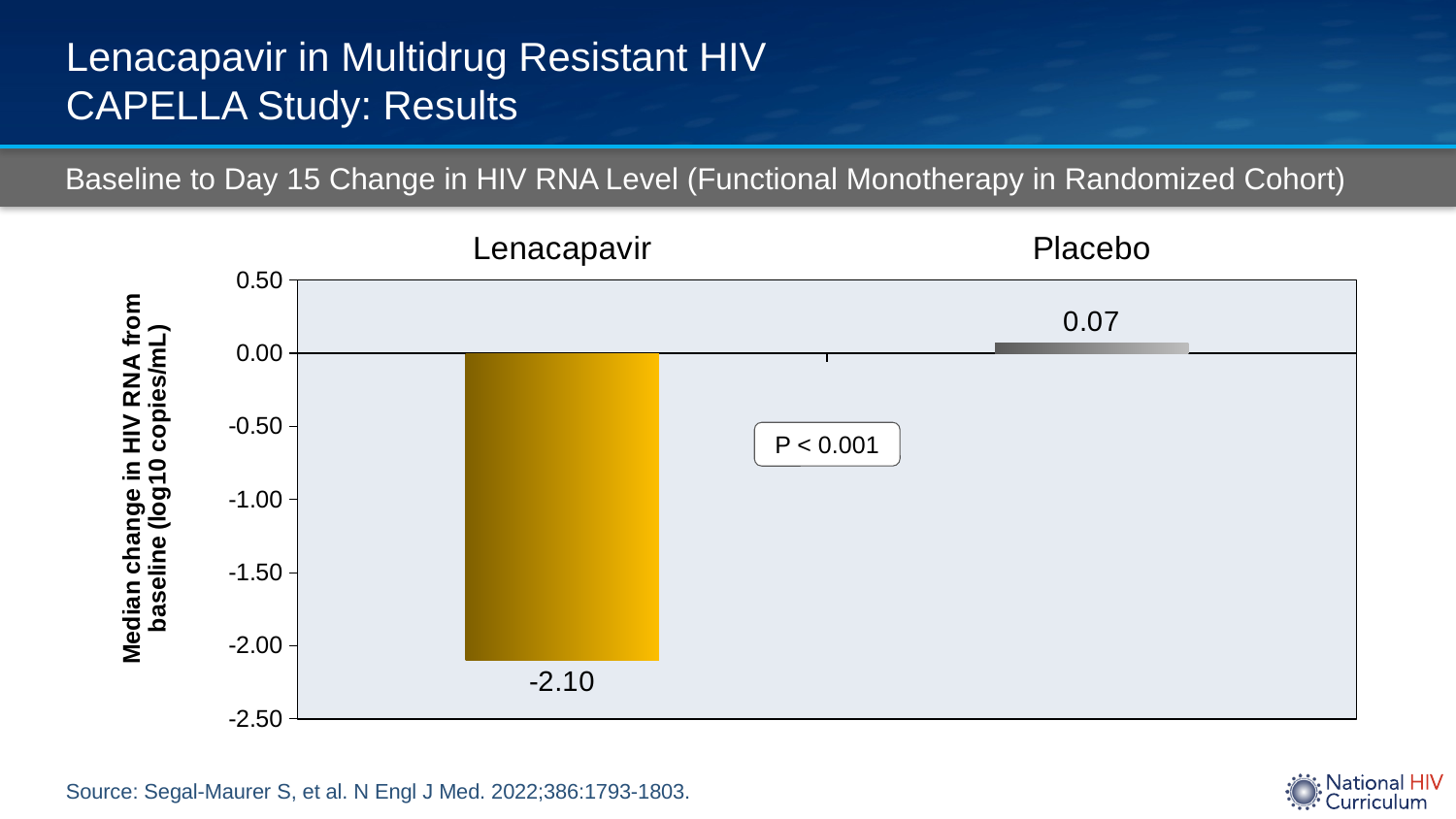
What is the label of the y axis? Median change in HIV RNA from baseline (log10 copies/mL) Is the value for Placebo greater or less than 0.00? greater Which group has the highest median change in HIV RNA from baseline? Placebo Which group has the lowest median change in HIV RNA from baseline? Lenacapavir Is the value for Lenacapavir greater or less than -2.00? less What is the median change in HIV RNA from baseline for Lenacapavir? -2.10 Which value is larger, Lenacapavir or Placebo? Placebo How many groups are plotted in the chart? 2 What P value is shown on the chart? P < 0.001 What kind of chart is shown on the slide? Bar chart What is the difference between the Placebo value and the Lenacapavir value? 2.17 What is the median change in HIV RNA from baseline for Placebo? 0.07